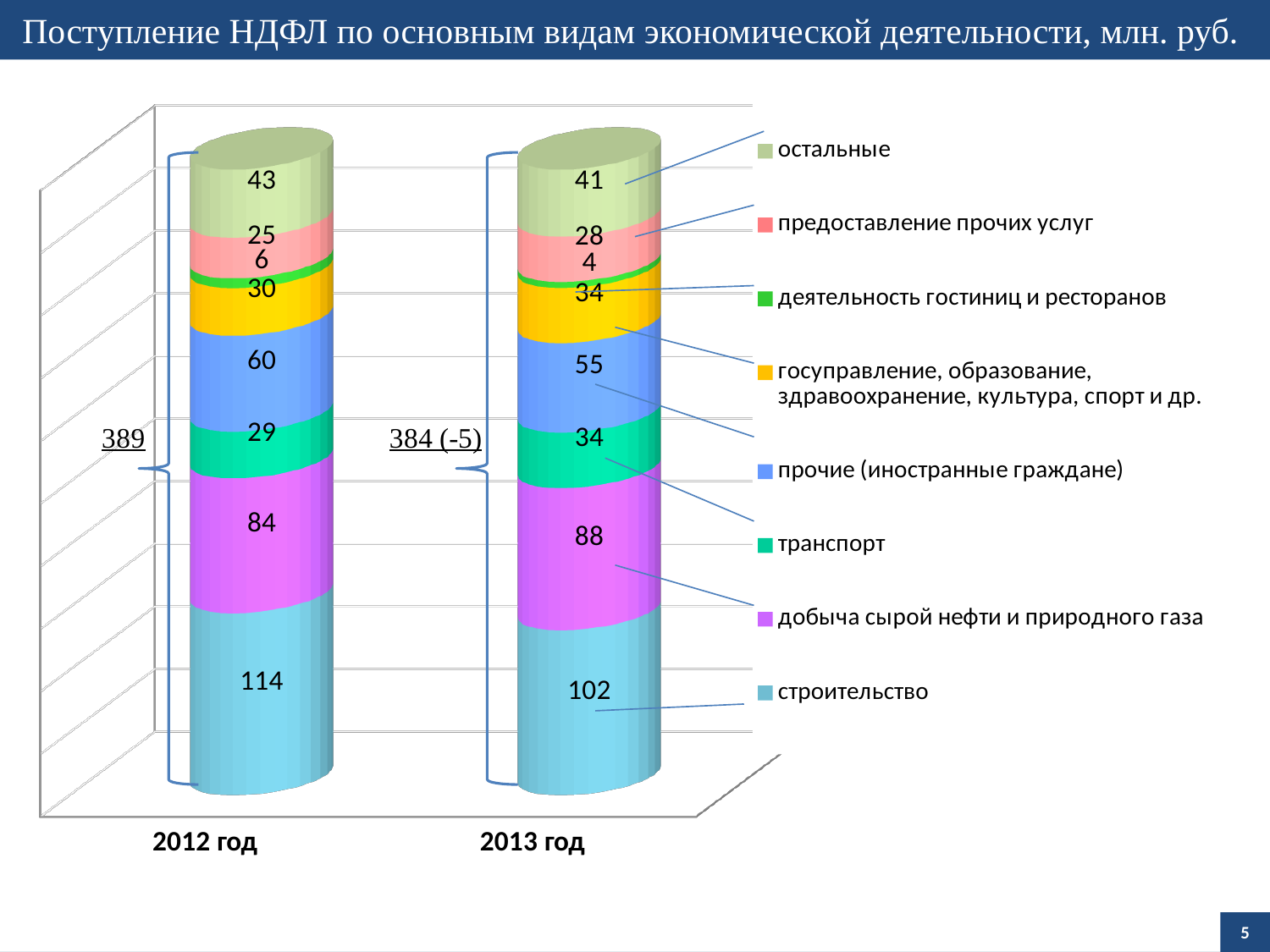
Which is larger: транспорт in 2012 год or транспорт in 2013 год? транспорт in 2013 год What is the value for добыча сырой нефти и природного газа in 2013 год? 88 How many series does the legend list? 8 What total is annotated next to the 2012 год bar? 389 What is the difference between the строительство values for 2012 год and 2013 год? 12 What kind of chart is shown on the slide? stacked bar chart How many years (categories) are shown on the x axis? 2 What is the value for строительство in 2012 год? 114 Which segment is the largest in the 2012 год bar? строительство Which segment is the smallest in the 2013 год bar? деятельность гостиниц и ресторанов What is the value for прочие (иностранные граждане) in 2013 год? 55 Does the value for строительство rise or fall from 2012 год to 2013 год? fall